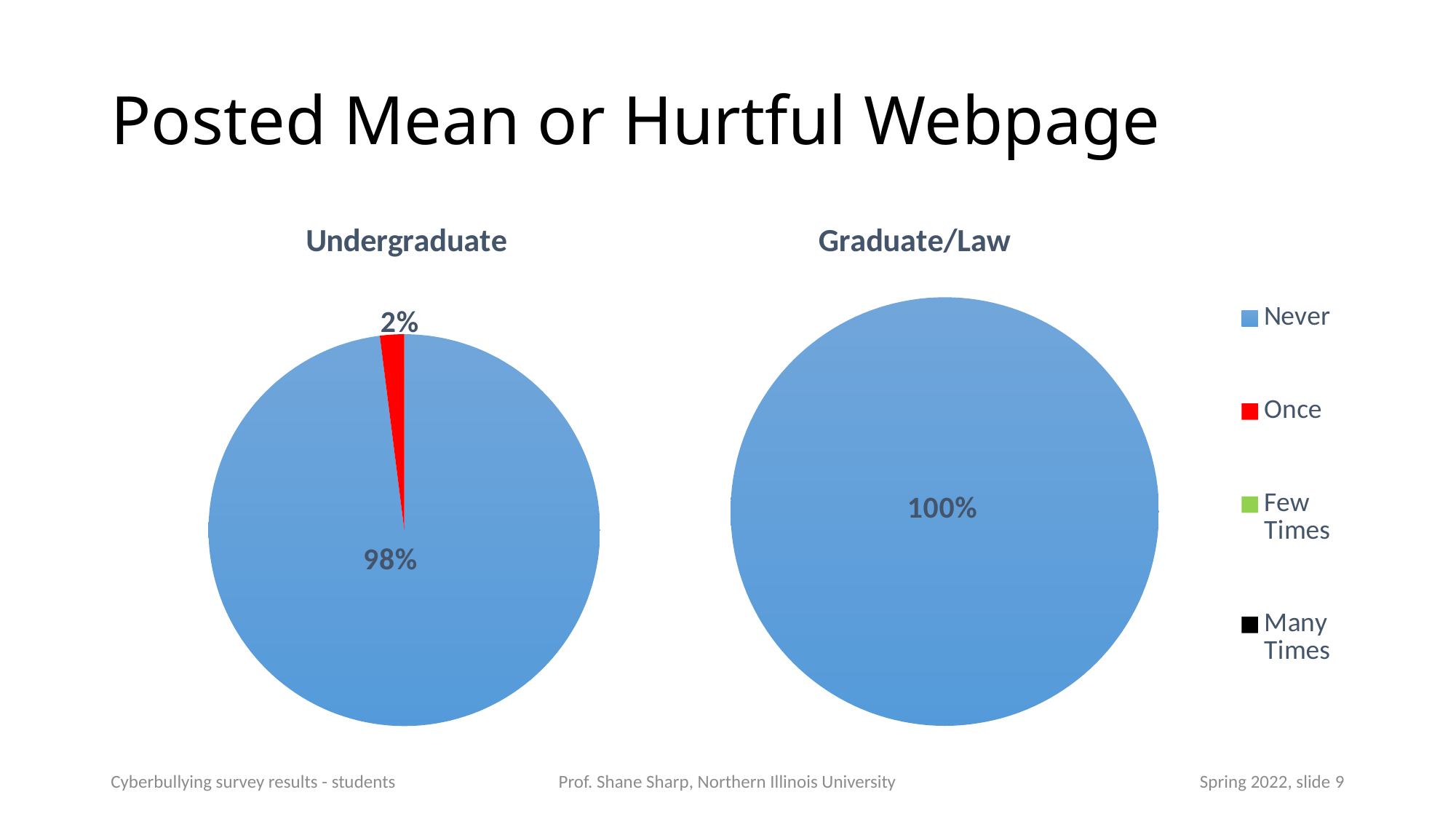
In the Graduate/Law chart, what share of respondents answered Never? 100% What is the title of the slide? Posted Mean or Hurtful Webpage In the Undergraduate chart, is the Never share greater or less than 90%? greater In the Undergraduate chart, which of the two labelled slices is larger, Never or Once? Never In the Undergraduate chart, what is the difference between the Never share and the Once share? 96% In the Undergraduate chart, which category has the largest slice? Never What kind of chart is the Undergraduate chart? Pie chart In the Undergraduate chart, what share of respondents answered Once? 2% What colour represents the Once category in the legend? Red How many categories does the legend list? 4 How many charts are shown on the slide? 2 In the Undergraduate chart, what share of respondents answered Never? 98%